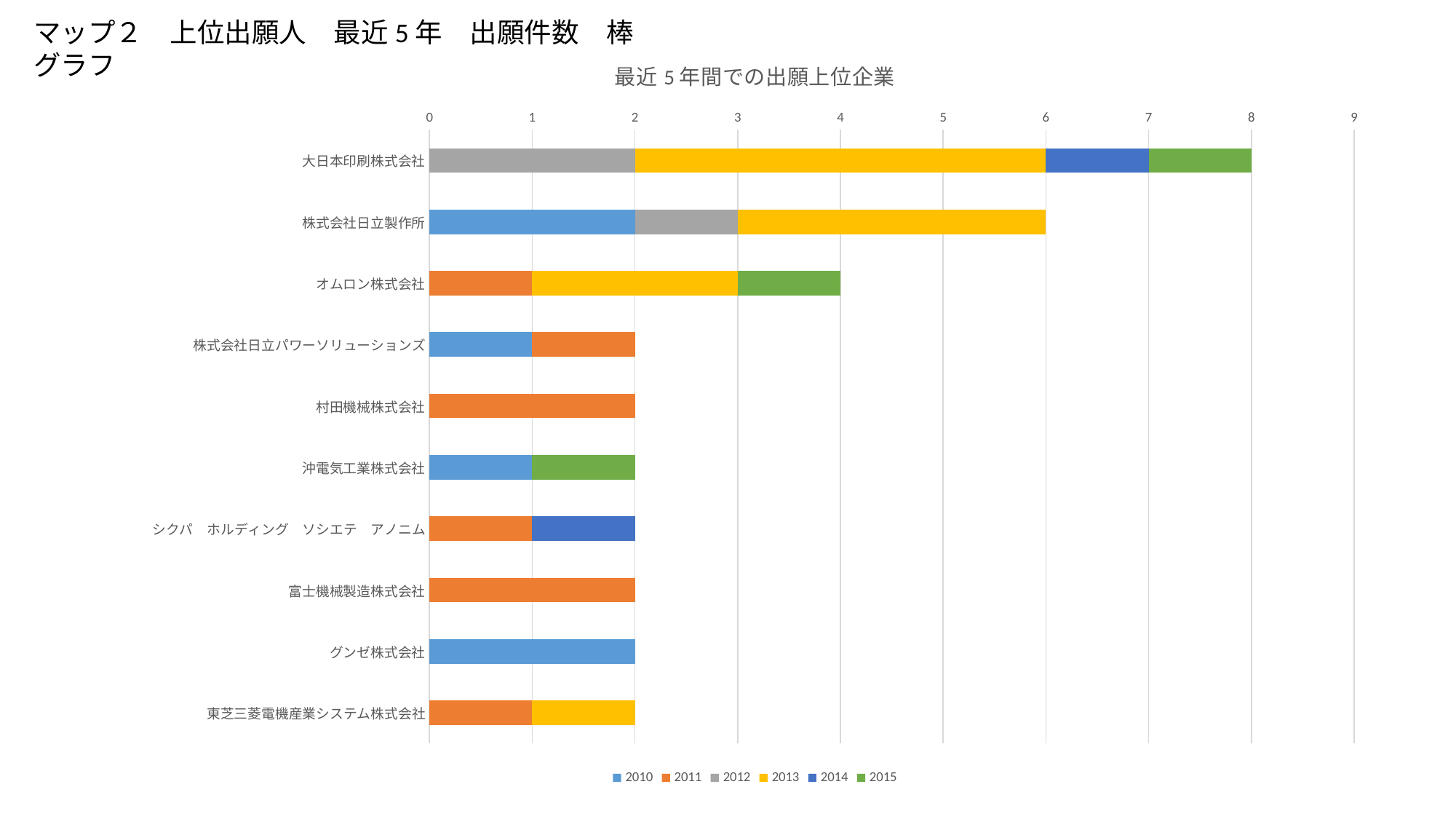
What is the value for 2010 for グンゼ株式会社? 2 How many series does the legend list? 6 What is the total length of the stacked bar for 株式会社日立製作所? 6 What is the difference between the total for 大日本印刷株式会社 and the total for 株式会社日立製作所? 2 How many companies are shown on the chart? 10 What is the total length of the stacked bar for オムロン株式会社? 4 What is the value for 2013 for 大日本印刷株式会社? 4 What is the title of the chart? 最近5年間での出願上位企業 Which has a larger total, オムロン株式会社 or 村田機械株式会社? オムロン株式会社 Which company has the highest total number of applications? 大日本印刷株式会社 What is the total length of the stacked bar for 大日本印刷株式会社? 8 What kind of chart is shown on the slide? Stacked bar chart